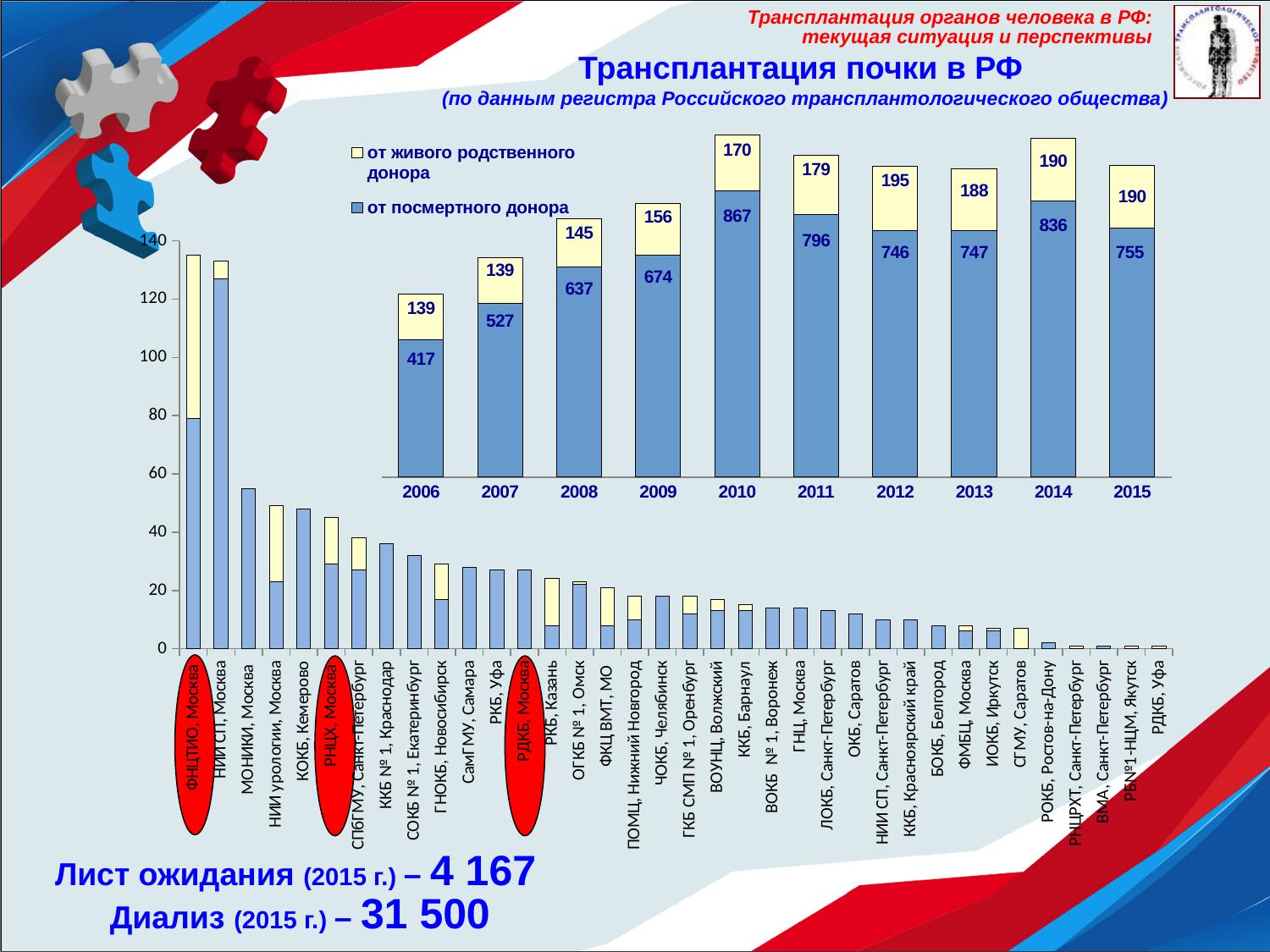
In the chart by year (2006–2015), what is the difference between posthumous-donor transplants in 2014 and in 2015? 81 In the chart by year (2006–2015), how many kidney transplants from a posthumous donor were performed in 2010? 867 In the chart by year (2006–2015), were there more living related donor transplants in 2011 or in 2013? 2013 What kind of chart is the chart by transplant center? Stacked bar chart In the chart by year (2006–2015), which year had the lowest number of transplants from a posthumous donor? 2006 In the chart by year (2006–2015), how many years are shown on the x axis? 10 In the chart by year (2006–2015), how many transplants from a living related donor were performed in 2012? 195 In the chart by transplant center, is the total value for МОНИКИ, Москва greater or less than 40? greater In the chart by year (2006–2015), which year had the highest number of transplants from a posthumous donor? 2010 In the chart by year (2006–2015), did the number of posthumous-donor transplants rise or fall from 2006 to 2010? rise In the chart by year (2006–2015), what is the total number of transplants in 2015 (posthumous plus living related donor)? 945 How many series does the legend list? 2